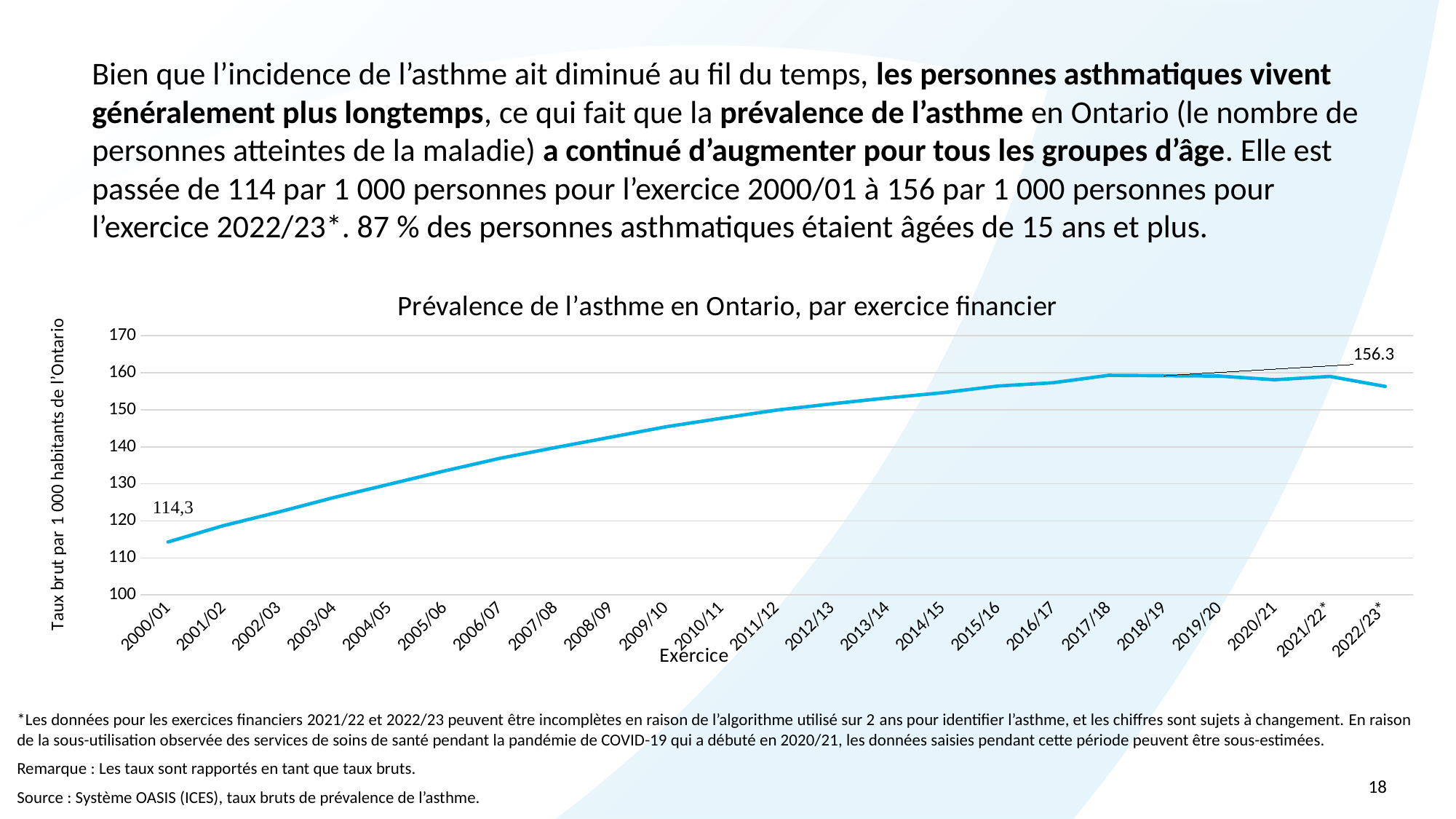
What is the title of the chart? Prévalence de l'asthme en Ontario, par exercice financier How many fiscal years are plotted on the x axis? 23 Which is larger, the prevalence rate in 2005/06 or in 2010/11? 2010/11 Does the prevalence rate generally rise or fall from 2000/01 to 2017/18? Rise What type of chart is shown on the slide? Line chart What is the asthma prevalence rate for fiscal year 2022/23*? 156.3 Which fiscal year has the lowest prevalence rate on the chart? 2000/01 Is the value for 2010/11 greater or less than 140? greater What is the asthma prevalence rate for fiscal year 2000/01? 114,3 What is the difference between the prevalence rate in 2022/23* and in 2000/01? 42 What is the label of the vertical axis? Taux brut par 1 000 habitants de l'Ontario Is the value for 2005/06 greater or less than 140? less